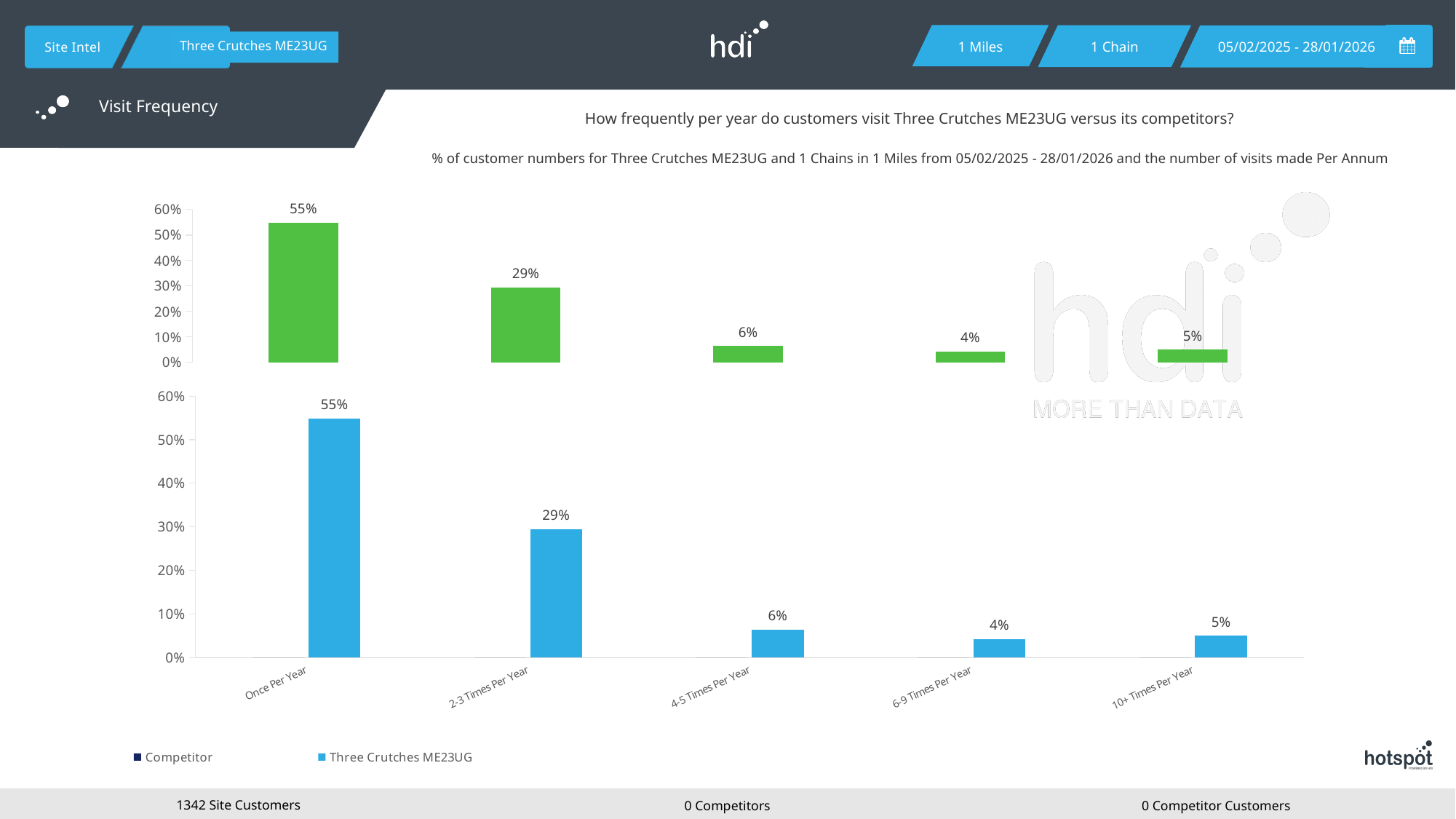
In the bottom chart, what is the value for 6-9 Times Per Year? 4% In the bottom chart, what is the value for 10+ Times Per Year? 5% In the bottom chart, which category has the highest value? Once Per Year In the bottom chart, which category has the lowest value? 6-9 Times Per Year In the bottom chart, what is the value for 2-3 Times Per Year? 29% In the top chart, what is the value shown on the first (leftmost) bar? 55% How many categories are shown on the x axis of the bottom chart? 5 How many series does the legend at the bottom of the slide list? 2 In the bottom chart, what is the value for Once Per Year? 55% What kind of chart is the bottom chart? bar chart In the bottom chart, what is the difference between the values for Once Per Year and 2-3 Times Per Year? 26% In the bottom chart, which is larger, the value for 4-5 Times Per Year or the value for 10+ Times Per Year? 4-5 Times Per Year